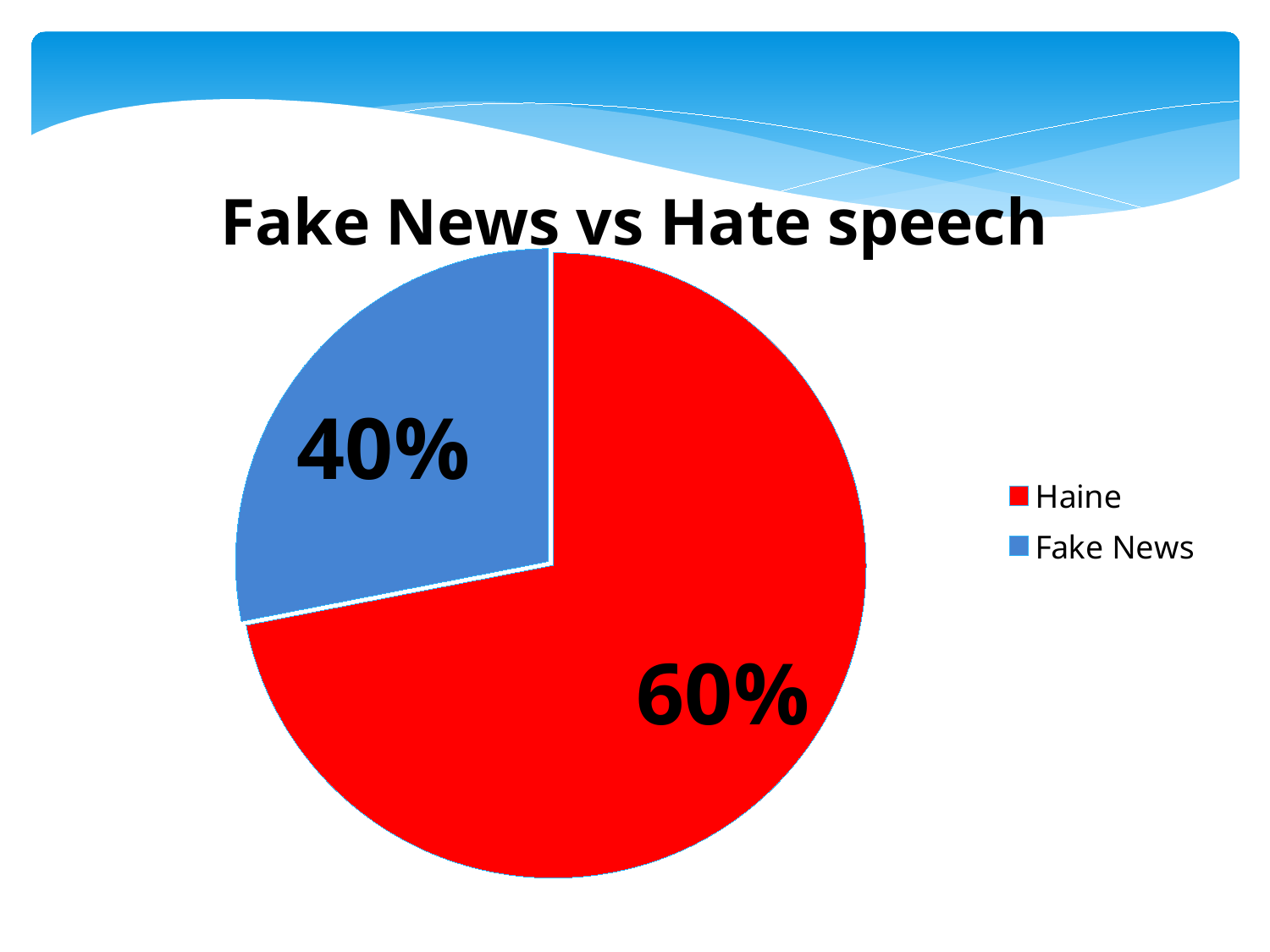
What is the title of the chart? Fake News vs Hate speech Is the share for Fake News greater or less than 50%? less Which category has the largest slice of the pie? Haine What colour is the Haine slice? Red What share of the pie does Fake News represent? 40% How many slices does the pie chart have? 2 Which is larger, the Haine slice or the Fake News slice? Haine How many entries does the legend list? 2 What share of the pie does Haine represent? 60% What kind of chart is shown on the slide? Pie chart What is the difference in percentage points between the Haine slice and the Fake News slice? 20% Which category has the smallest slice of the pie? Fake News